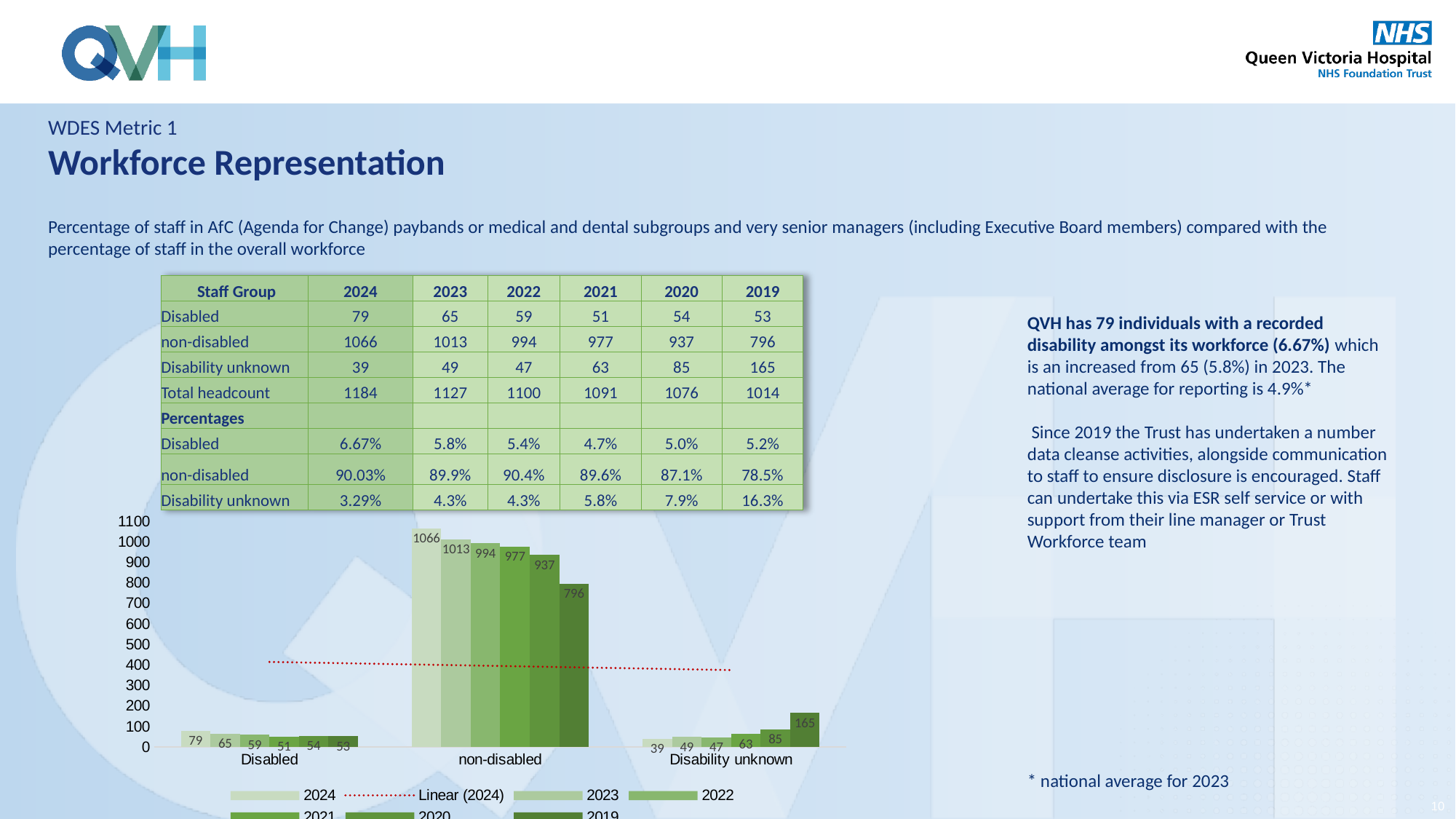
Which legend entry is drawn as a dotted line rather than bars? Linear (2024) What type of chart is shown on the slide? bar chart How many entries does the chart legend list? 7 What is the difference between the non-disabled values for 2024 and 2019? 270 What is the value for Disabled in 2021? 51 Which year has the lowest value for Disability unknown? 2024 Which year has the highest value for non-disabled? 2024 Is the value for non-disabled in 2019 greater or less than 700? greater Which is larger, the Disabled value for 2024 or the Disabled value for 2023? 2024 What is the value for non-disabled in 2024? 1066 What is the value for Disability unknown in 2019? 165 How many categories are shown on the x axis of the chart? 3